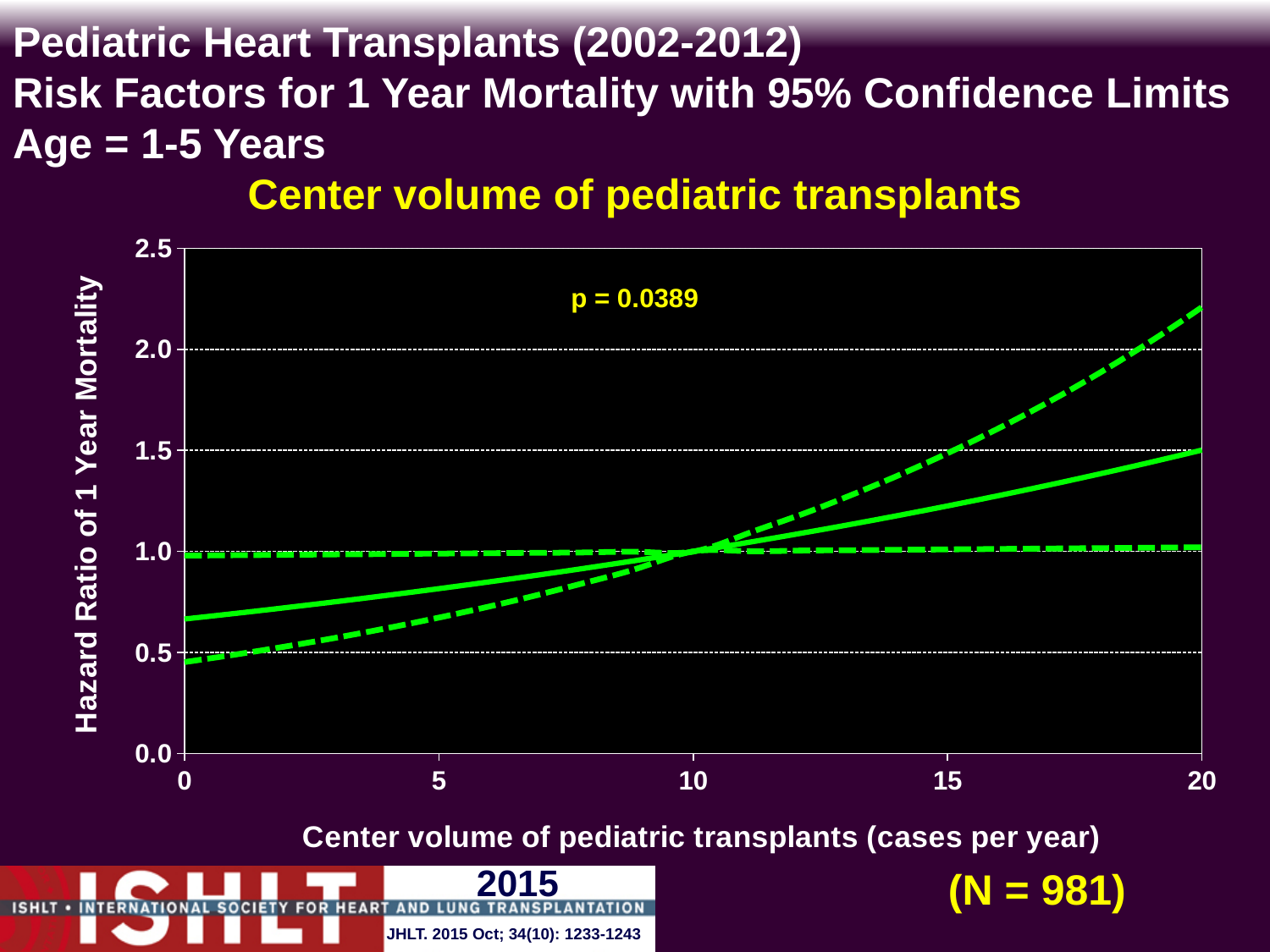
Is the hazard ratio (solid line) at a center volume of 15 cases per year greater or less than 1.5? less How many lines are plotted on the chart? 3 Is the lower 95% confidence limit (lower dashed line) at a center volume of 5 cases per year greater or less than 1.0? less Is the hazard ratio (solid line) at a center volume of 0 cases per year greater or less than 1.0? less What is the title of the chart? Center volume of pediatric transplants What is the highest value shown on the y axis? 2.5 Does the solid hazard ratio line rise or fall as center volume increases from 0 to 20 cases per year? rise What kind of chart is shown on the slide? line chart What p-value is printed on the chart? p = 0.0389